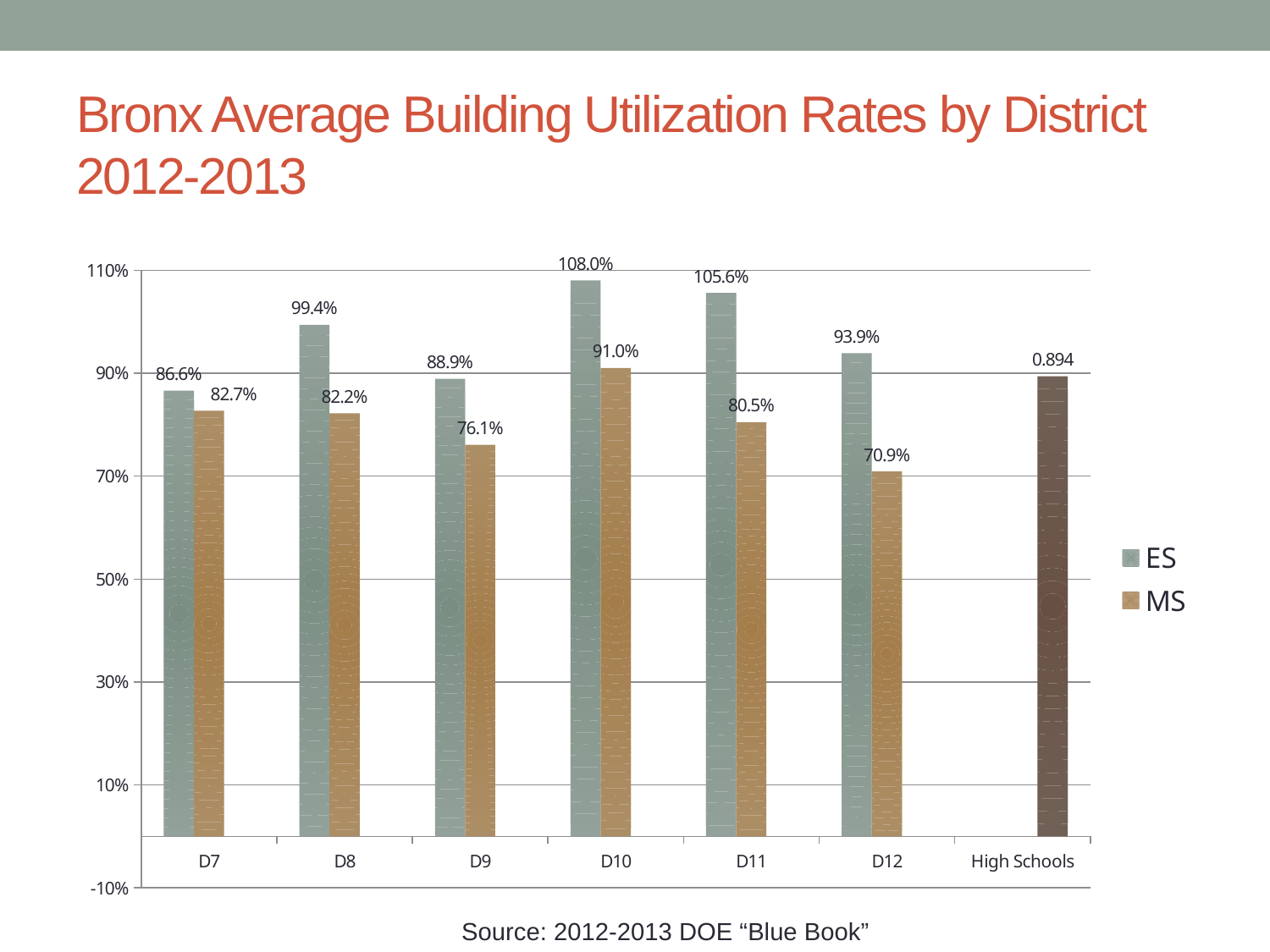
Which is larger, the MS rate for D7 or the MS rate for D8? D7 (82.7%) What is the difference between the ES and MS rates for D12? 23.0% How many categories are shown on the x axis? 7 What is the source cited below the chart? 2012-2013 DOE "Blue Book" Is the ES value for D11 greater or less than 90%? greater What kind of chart is shown on the slide? Bar chart What is the MS utilization rate for D9? 76.1% Which district has the lowest MS utilization rate? D12 What value is labeled on the High Schools bar? 0.894 Which district has the highest ES utilization rate? D10 How many series does the legend list? 2 What is the ES utilization rate for D10? 108.0%